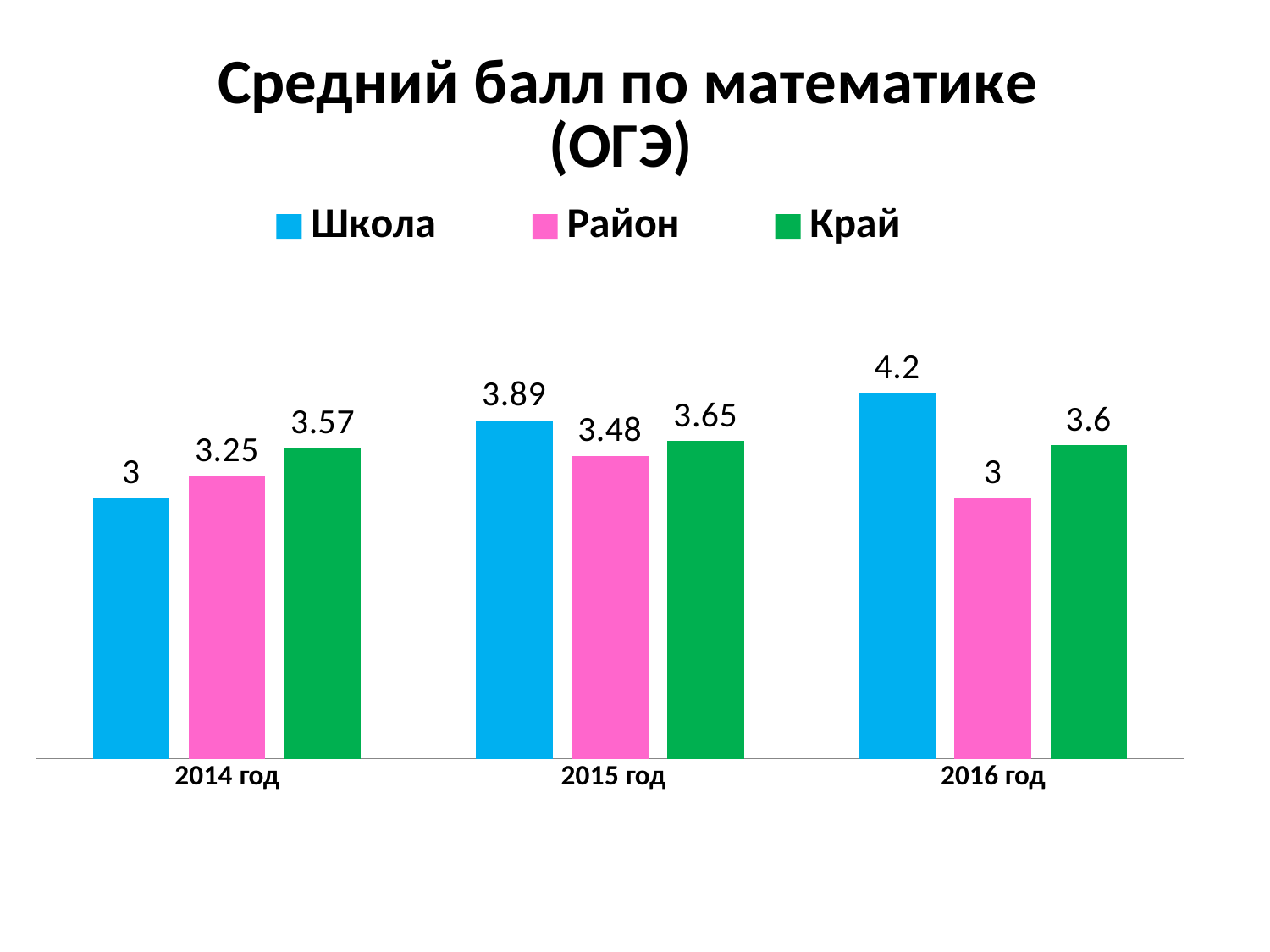
What is the value for Район in 2015 год? 3.48 In which year is the value for Район lowest? 2016 год Which is larger in 2015 год, Школа or Край? Школа What is the value for Школа in 2014 год? 3 How many years are shown on the x axis? 3 What is the value for Школа in 2016 год? 4.2 What is the difference between Край and Школа in 2014 год? 0.57 In which year is the value for Школа highest? 2016 год What is the value for Край in 2016 год? 3.6 What kind of chart is shown on the slide? Bar chart How many series does the legend list? 3 What is the difference between Школа and Район in 2016 год? 1.2